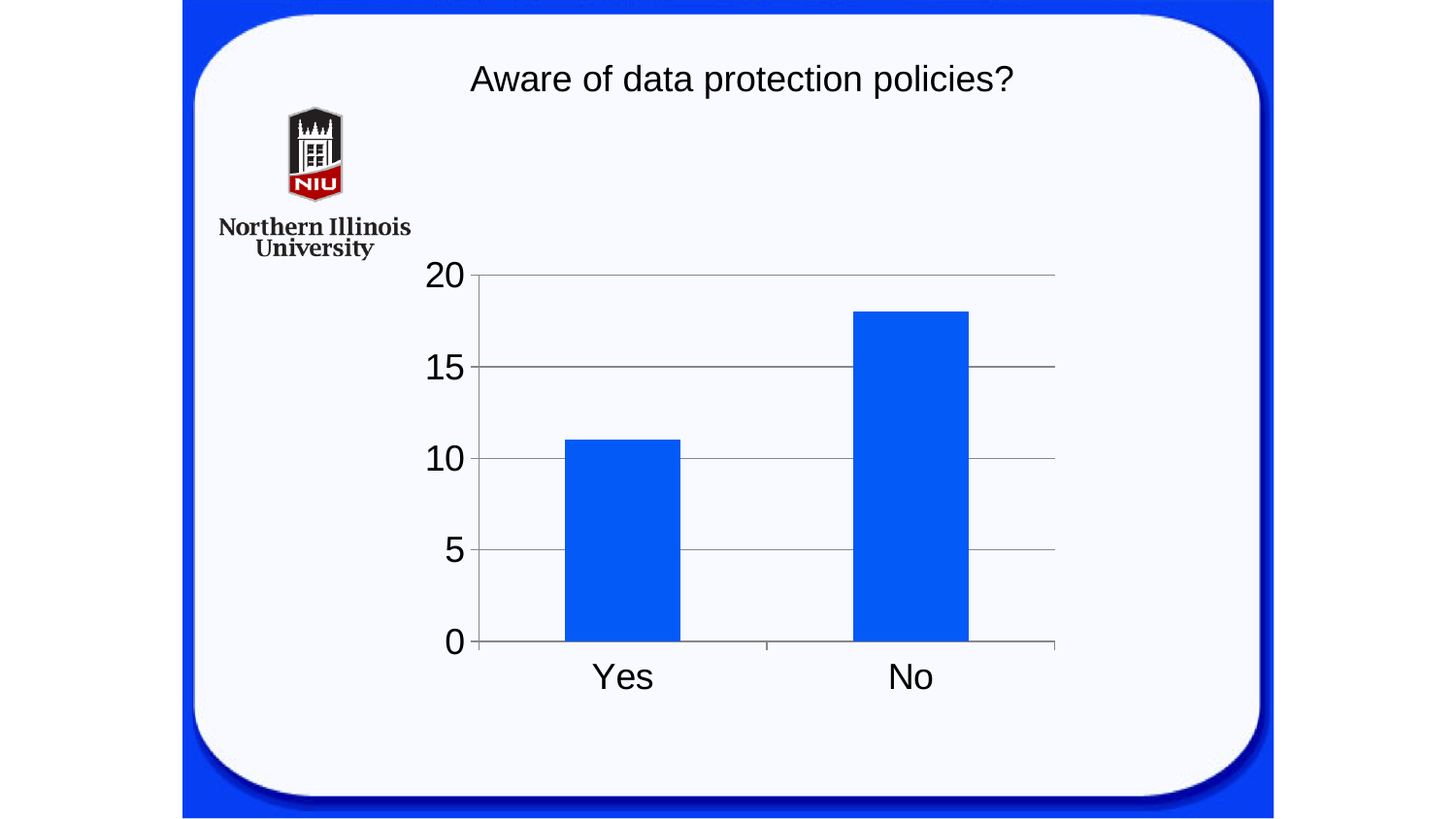
What kind of chart is shown on the slide? bar chart What is the title of the chart? Aware of data protection policies? How many categories are shown on the x axis of the chart? 2 Is the value for No greater or less than 15? greater What is the highest value shown on the y axis of the chart? 20 Which category has the highest value in the chart? No Do the values rise or fall from Yes to No along the x axis? rise Which category has the lowest value in the chart? Yes Which is larger, the value for Yes or the value for No? No Is the value for Yes greater or less than 15? less Is the value for Yes greater or less than 10? greater